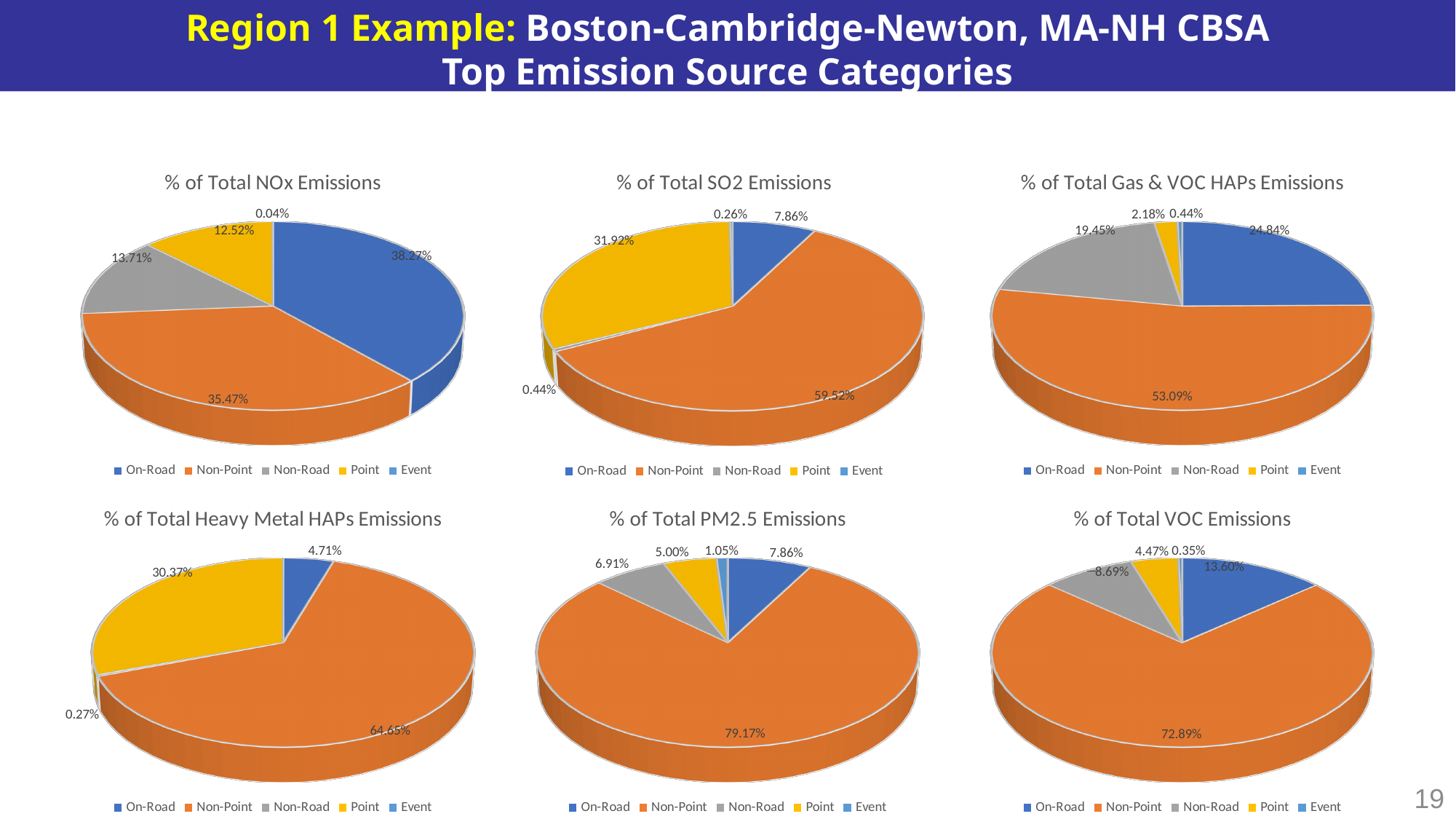
In the '% of Total Heavy Metal HAPs Emissions' chart, what percentage is shown for Point? 30.37% In the '% of Total NOx Emissions' chart, which source category has the largest share? On-Road In the '% of Total Heavy Metal HAPs Emissions' chart, which source category has the largest share? Non-Point In the '% of Total PM2.5 Emissions' chart, what percentage is shown for Non-Point? 79.17% In the '% of Total PM2.5 Emissions' chart, which is larger, the On-Road share or the Non-Road share? On-Road What type of chart is used for '% of Total NOx Emissions'? Pie chart In the '% of Total Gas & VOC HAPs Emissions' chart, what percentage is shown for Non-Road? 19.45% How many source categories does the legend of the '% of Total VOC Emissions' chart list? 5 In the '% of Total SO2 Emissions' chart, what is the difference between the Non-Point and Point shares? 27.60% In the '% of Total VOC Emissions' chart, what percentage is shown for On-Road? 13.60% In the '% of Total NOx Emissions' chart, what percentage is shown for On-Road? 38.27% In the '% of Total SO2 Emissions' chart, what percentage is shown for Non-Point? 59.52%